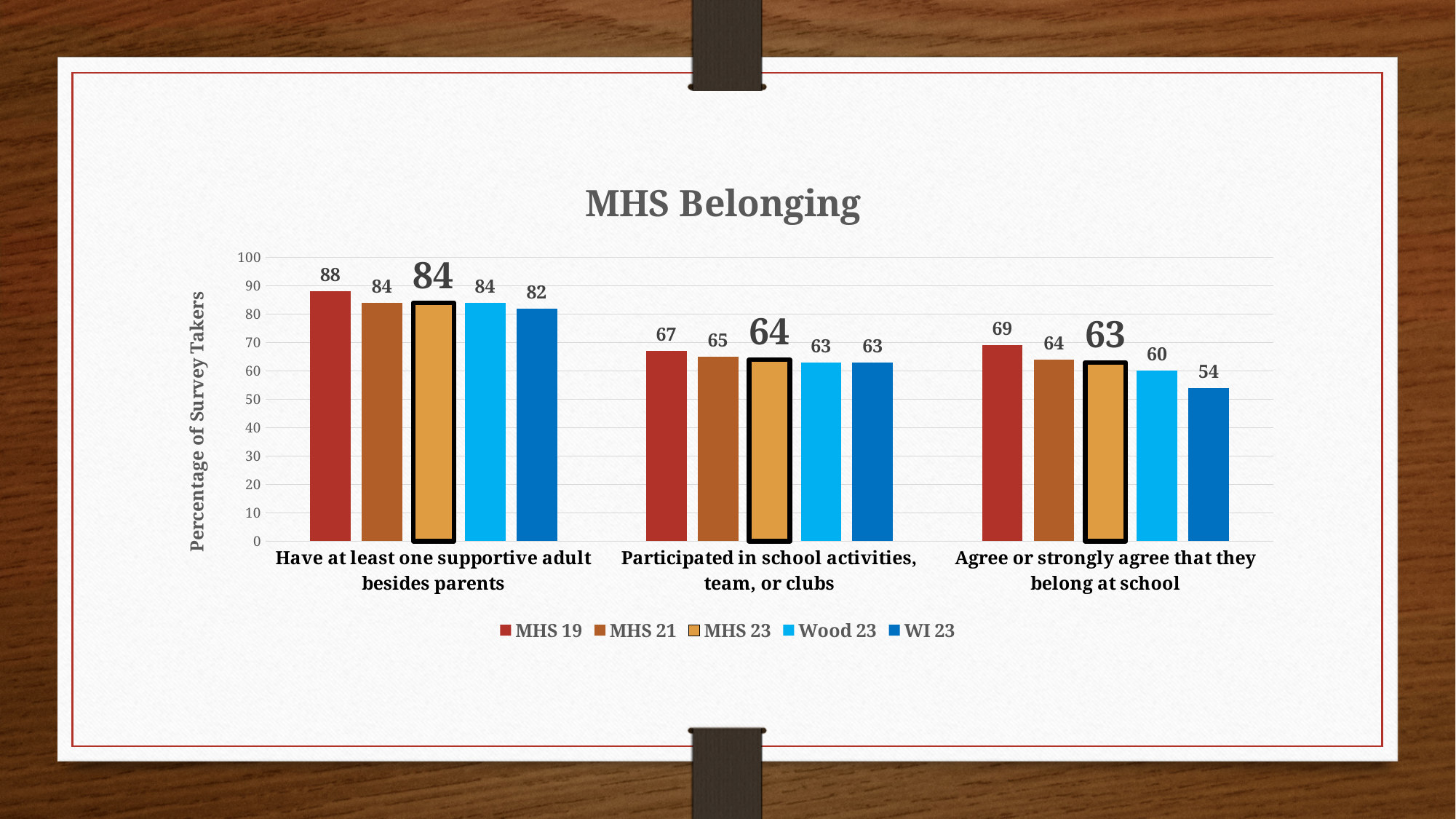
What is the difference between MHS 19 and MHS 23 in the 'Have at least one supportive adult besides parents' category? 4 How many categories are shown on the x axis? 3 What is the value for WI 23 in the 'Agree or strongly agree that they belong at school' category? 54 What kind of chart is shown on the slide? Bar chart How many series does the legend list? 5 Which series has the highest value in the 'Agree or strongly agree that they belong at school' category? MHS 19 What is the title of the chart? MHS Belonging Which is larger: Wood 23 or WI 23 in the 'Agree or strongly agree that they belong at school' category? Wood 23 What is the difference between MHS 19 and WI 23 in the 'Agree or strongly agree that they belong at school' category? 15 What is the value for MHS 23 in the 'Participated in school activities, team, or clubs' category? 64 What is the value for MHS 19 in the 'Have at least one supportive adult besides parents' category? 88 Which series has the lowest value in the 'Agree or strongly agree that they belong at school' category? WI 23